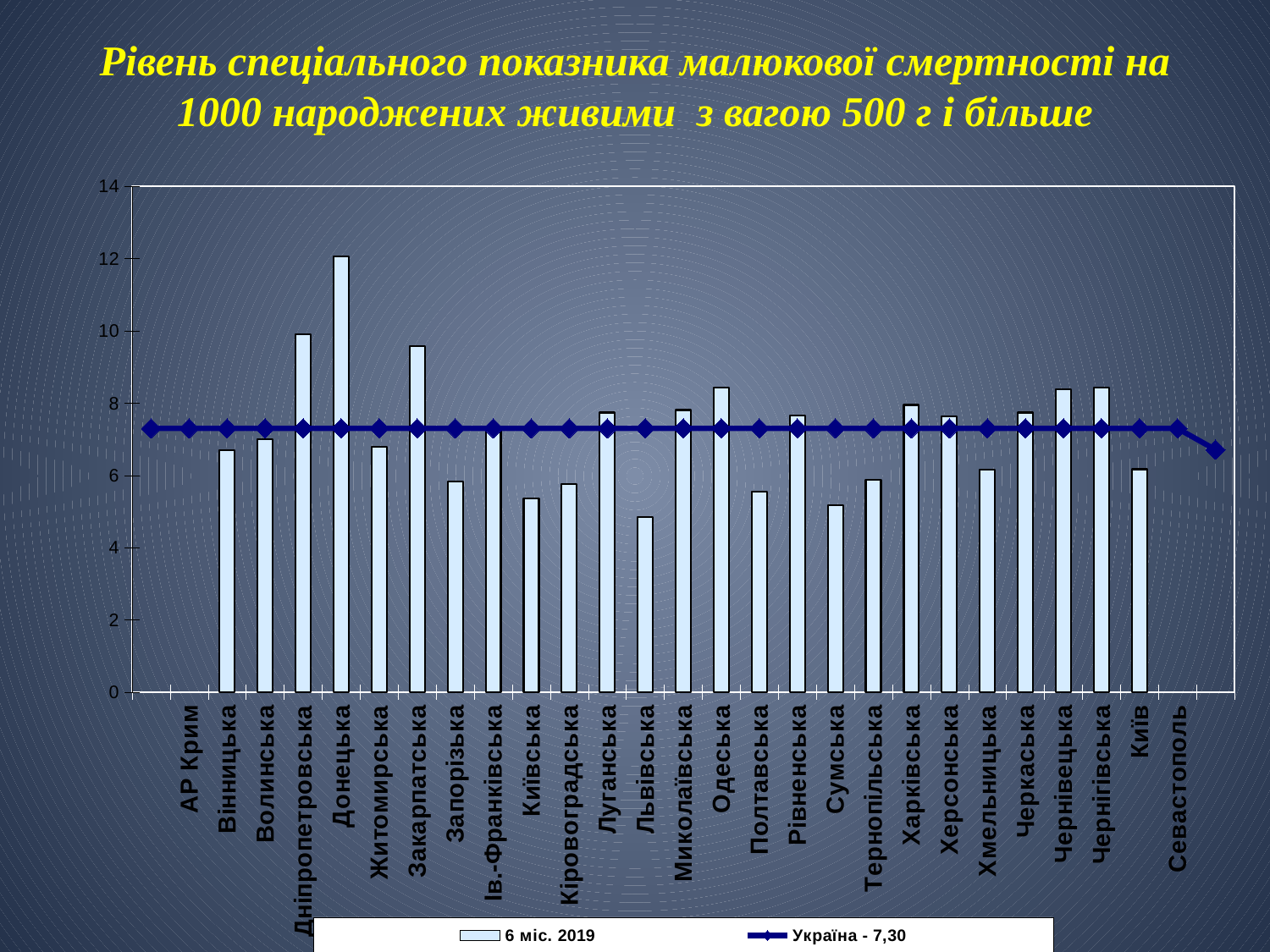
Which region has the highest bar? Донецька What value for Україна is given in the legend? 7,30 Which is larger, the bar for Одеська or the bar for Львівська? Одеська Is the value for Дніпропетровська greater or less than 8? greater How many categories are labelled on the x axis? 27 Which is larger, the bar for Донецька or the bar for Дніпропетровська? Донецька What kind of chart is shown on the slide? bar and line chart Is the value for Закарпатська greater or less than 8? greater Is the value for Львівська greater or less than 6? less How many series does the legend list? 2